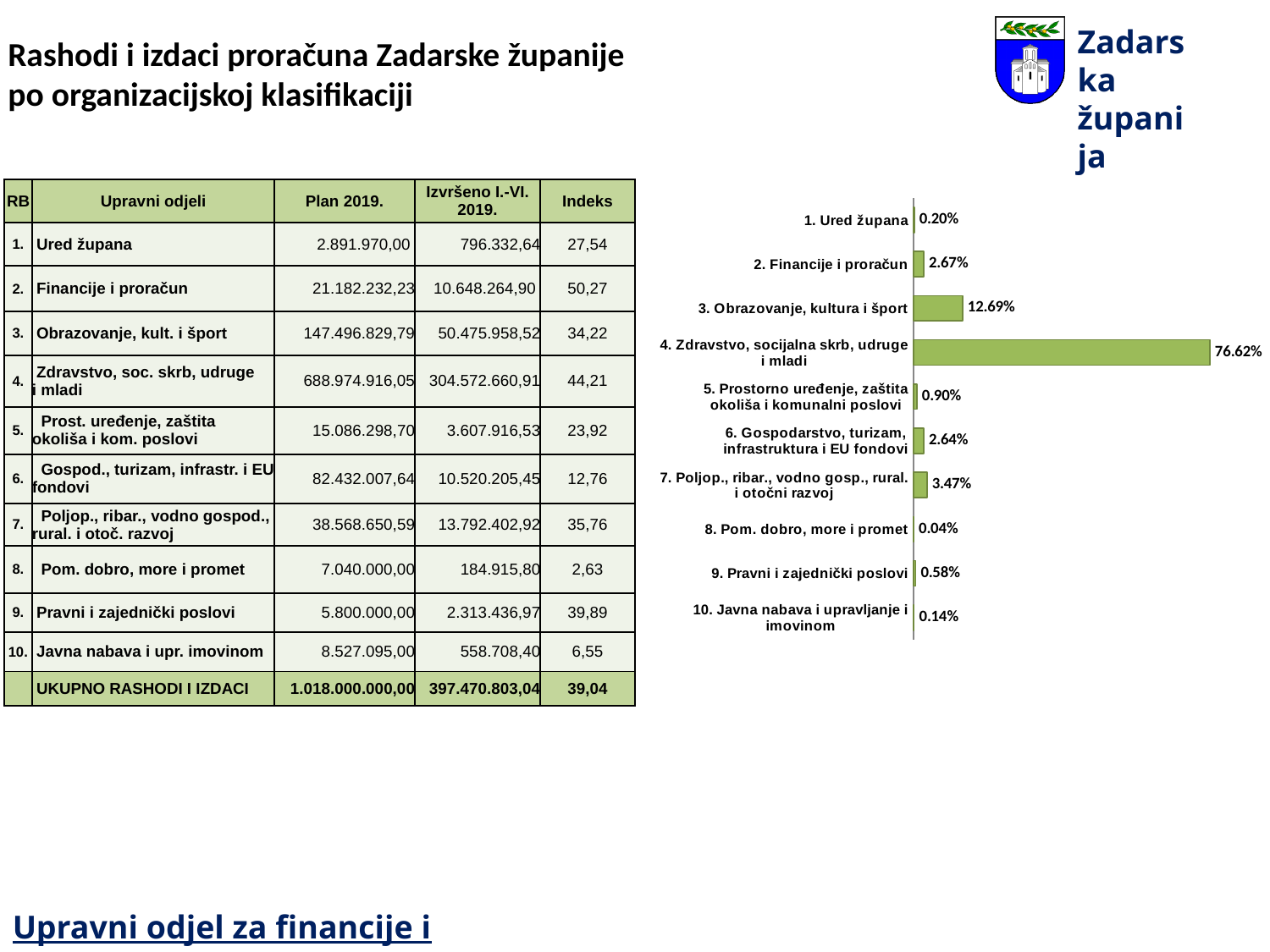
In the bar chart, what is the value for "10. Javna nabava i upravljanje i imovinom"? 0.14% In the bar chart, what is the difference between the values for "4. Zdravstvo, socijalna skrb, udruge i mladi" and "3. Obrazovanje, kultura i šport"? 63.93% What kind of chart is shown on the right side of the slide? Bar chart In the bar chart, what is the difference between the values for "7. Poljop., ribar., vodno gosp., rural. i otočni razvoj" and "6. Gospodarstvo, turizam, infrastruktura i EU fondovi"? 0.83% How many categories are shown in the bar chart? 10 In the bar chart, which has the larger value: "7. Poljop., ribar., vodno gosp., rural. i otočni razvoj" or "2. Financije i proračun"? 7. Poljop., ribar., vodno gosp., rural. i otočni razvoj Which category has the lowest value in the bar chart? 8. Pom. dobro, more i promet Which category has the highest value in the bar chart? 4. Zdravstvo, socijalna skrb, udruge i mladi In the bar chart, what is the value for "1. Ured župana"? 0.20% In the bar chart, what is the value for "4. Zdravstvo, socijalna skrb, udruge i mladi"? 76.62% In the bar chart, what is the value for "3. Obrazovanje, kultura i šport"? 12.69% What colour are the bars in the chart? Green